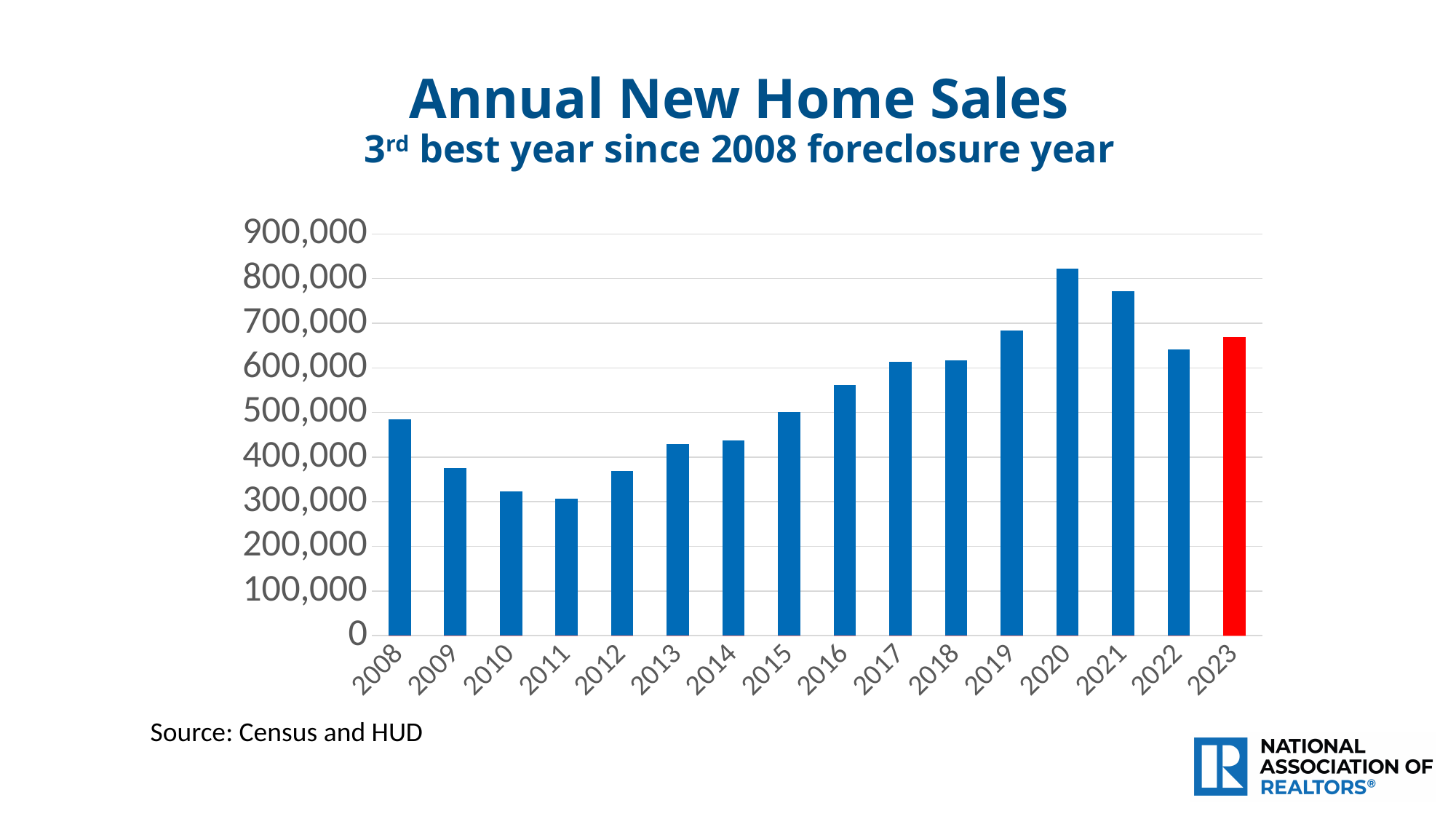
Is the value for 2023 greater or less than 600,000? greater Which year has higher new home sales, 2020 or 2021? 2020 Is the value for 2011 greater or less than 400,000? less Do annual new home sales rise or fall from 2011 to 2020? rise Which year's bar is coloured red instead of blue? 2023 Is the value for 2009 greater or less than 400,000? less What kind of chart is shown on the slide? bar chart Which year has higher new home sales, 2022 or 2023? 2023 Which year has the lowest annual new home sales? 2011 How many years are plotted on the chart? 16 Which year has the highest annual new home sales? 2020